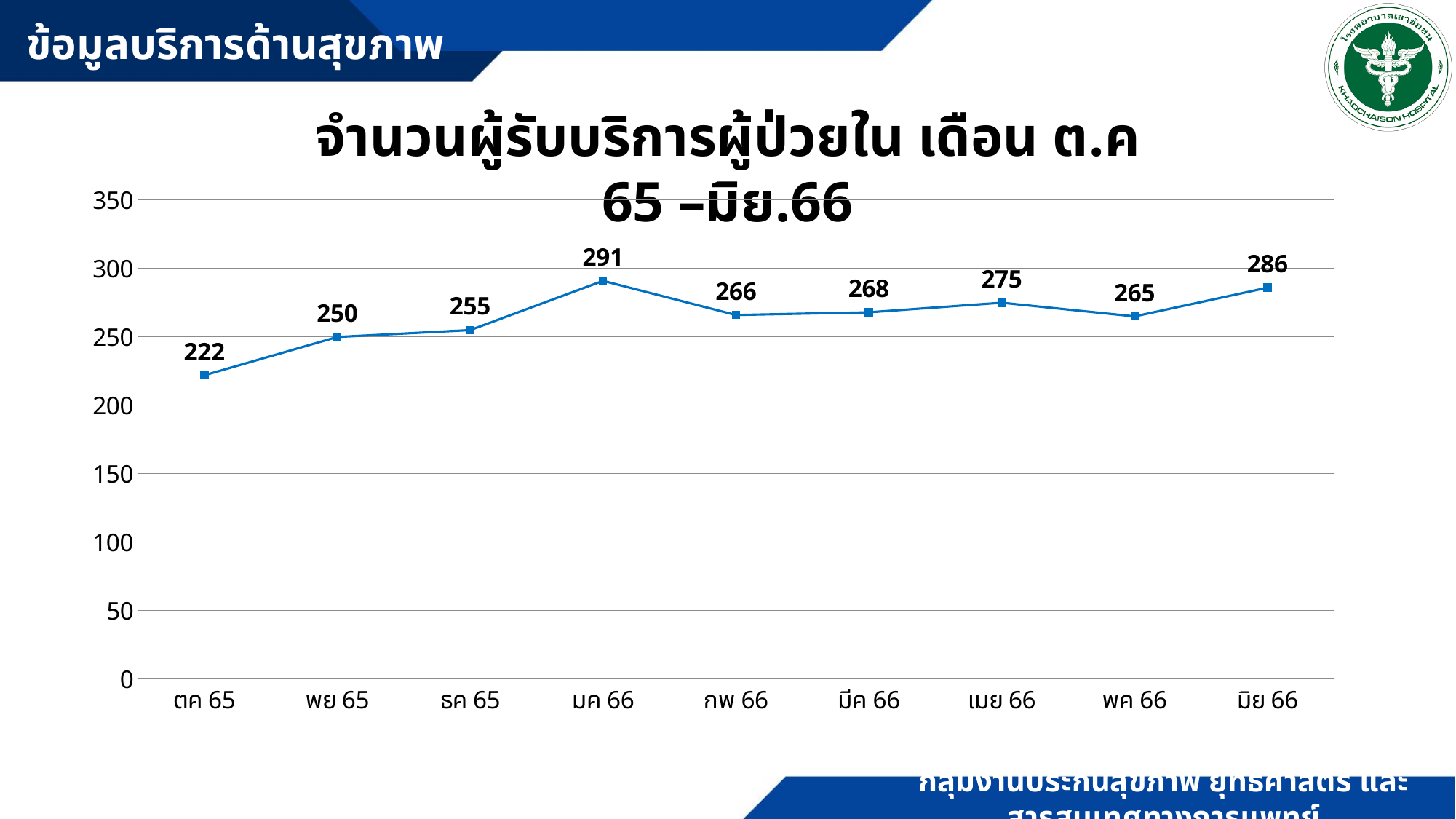
What is the difference between the values for มค 66 and ตค 65? 69 What is the value for มค 66? 291 What is the value for ตค 65? 222 Does the value rise or fall from ตค 65 to มค 66? rise Which month has the lowest value? ตค 65 What is the value for มิย 66? 286 How many months are plotted on the chart? 9 What kind of chart is shown on the slide? line chart What is the difference between the values for มิย 66 and พค 66? 21 Which is larger, the value for เมย 66 or the value for พค 66? เมย 66 Which month has the highest value? มค 66 Is the value for ธค 65 greater or less than 250? greater